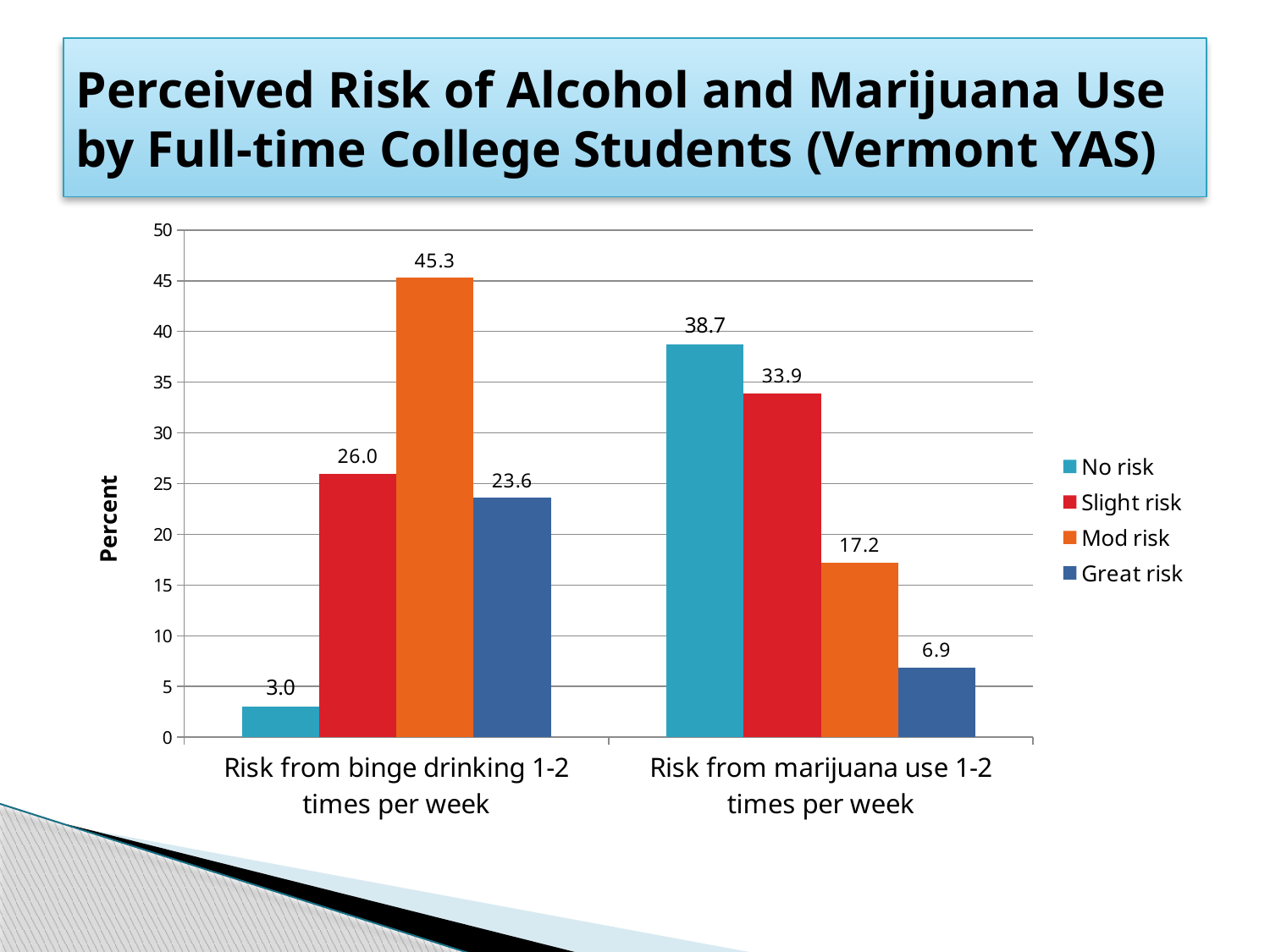
Which series has the lowest value in the 'Risk from marijuana use 1-2 times per week' category? Great risk What is the value for Mod risk in the 'Risk from binge drinking 1-2 times per week' category? 45.3 Which series has the highest value in the 'Risk from binge drinking 1-2 times per week' category? Mod risk What is the value for Great risk in the 'Risk from marijuana use 1-2 times per week' category? 6.9 How many categories are shown on the x axis? 2 What kind of chart is shown on the slide? Bar chart What is the value for No risk in the 'Risk from marijuana use 1-2 times per week' category? 38.7 How many series does the legend list? 4 What is the label of the y axis? Percent Which is larger: the No risk value for binge drinking or the No risk value for marijuana use? No risk for marijuana use Is the Great risk value for binge drinking greater or less than 20? greater What is the difference between the Slight risk values for marijuana use and binge drinking? 7.9